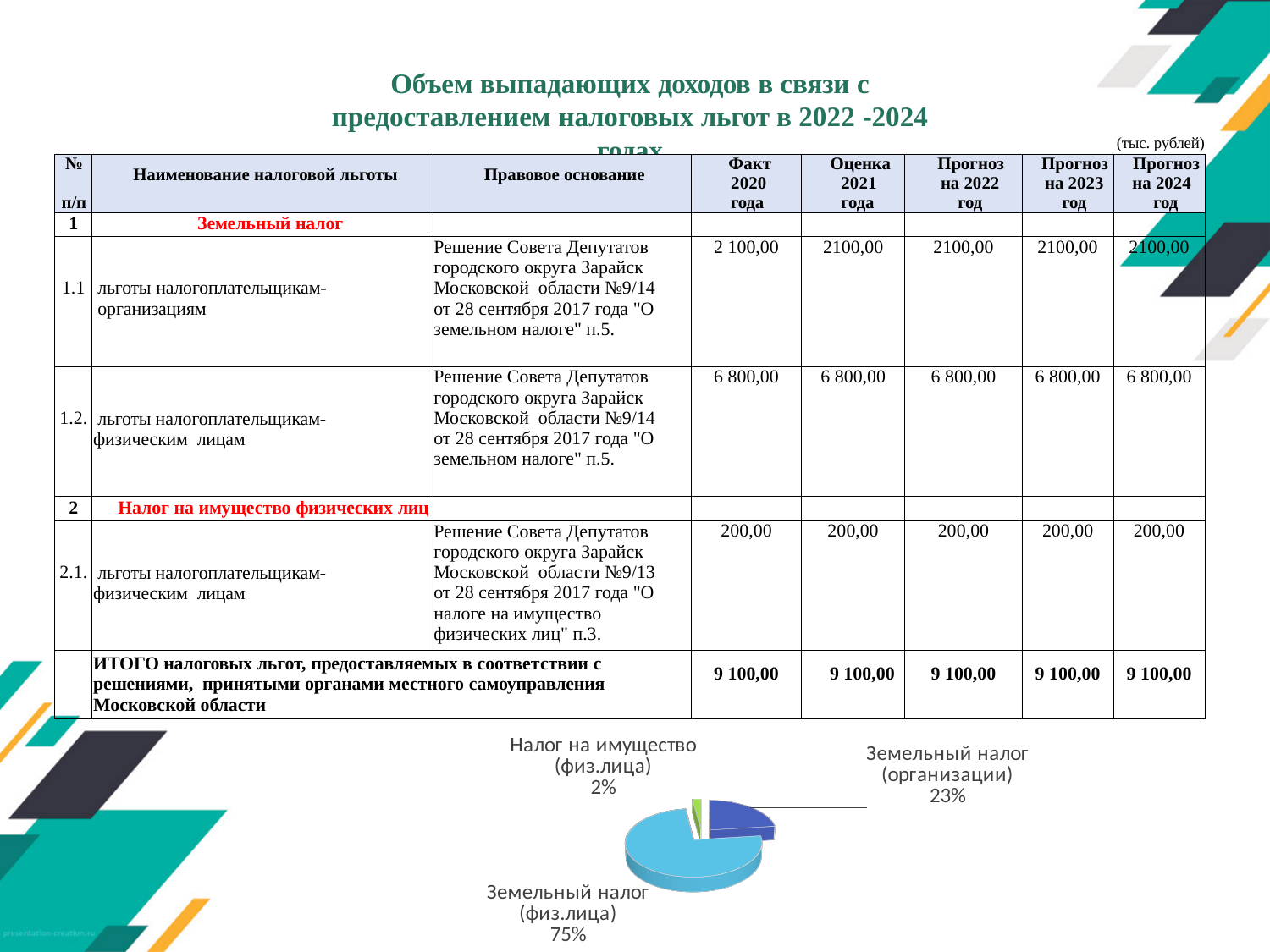
How many slices does the pie chart have? 3 Which is larger in the pie chart: "Земельный налог (организации)" or "Налог на имущество (физ.лица)"? Земельный налог (организации) What is the difference in percentage points between the "Земельный налог (физ.лица)" slice and the "Земельный налог (организации)" slice? 52 What colour is the largest slice of the pie chart? light blue What kind of chart is shown at the bottom of the slide? pie chart What share of the pie does "Земельный налог (физ.лица)" have? 75% What share of the pie does "Налог на имущество (физ.лица)" have? 2% What is the difference in percentage points between the "Земельный налог (организации)" slice and the "Налог на имущество (физ.лица)" slice? 21 Which slice of the pie chart is the largest? Земельный налог (физ.лица) Is the pie chart drawn in 3D? yes Which slice of the pie chart is the smallest? Налог на имущество (физ.лица) What share of the pie does "Земельный налог (организации)" have? 23%